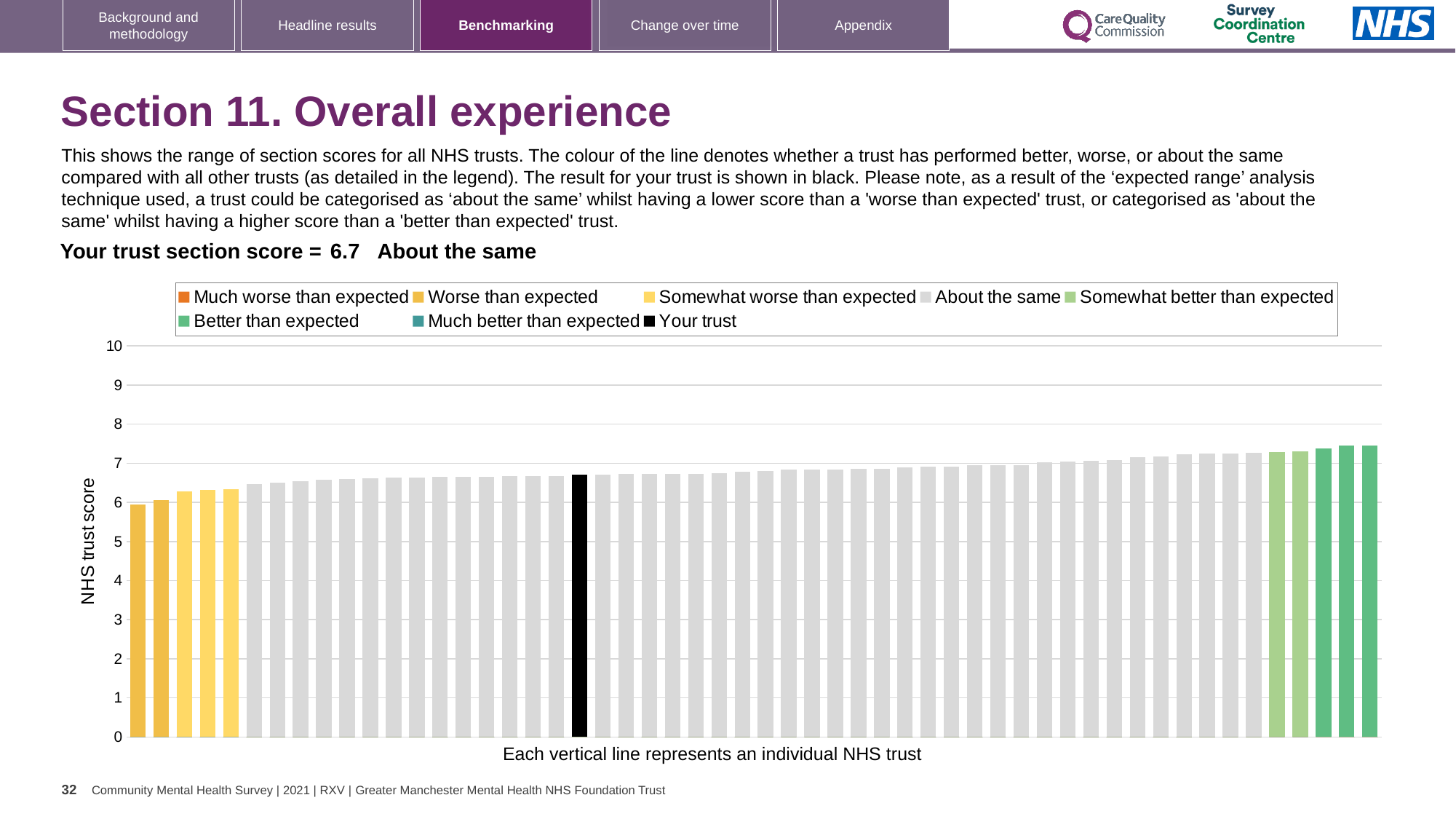
What is the section score for your trust shown on the slide? 6.7 Is the value for your trust (the black bar) greater or less than 5? greater What colour is the bar representing your trust? black What kind of chart is shown on the slide? bar chart Is the value for the tallest bar greater or less than 7? greater Is the value for the tallest bar greater or less than 8? less Do the bar values rise or fall from left to right along the x axis? rise Which benchmarking category is your trust's section score placed in? About the same How many entries does the chart legend list? 8 What is the label on the vertical axis of the chart? NHS trust score